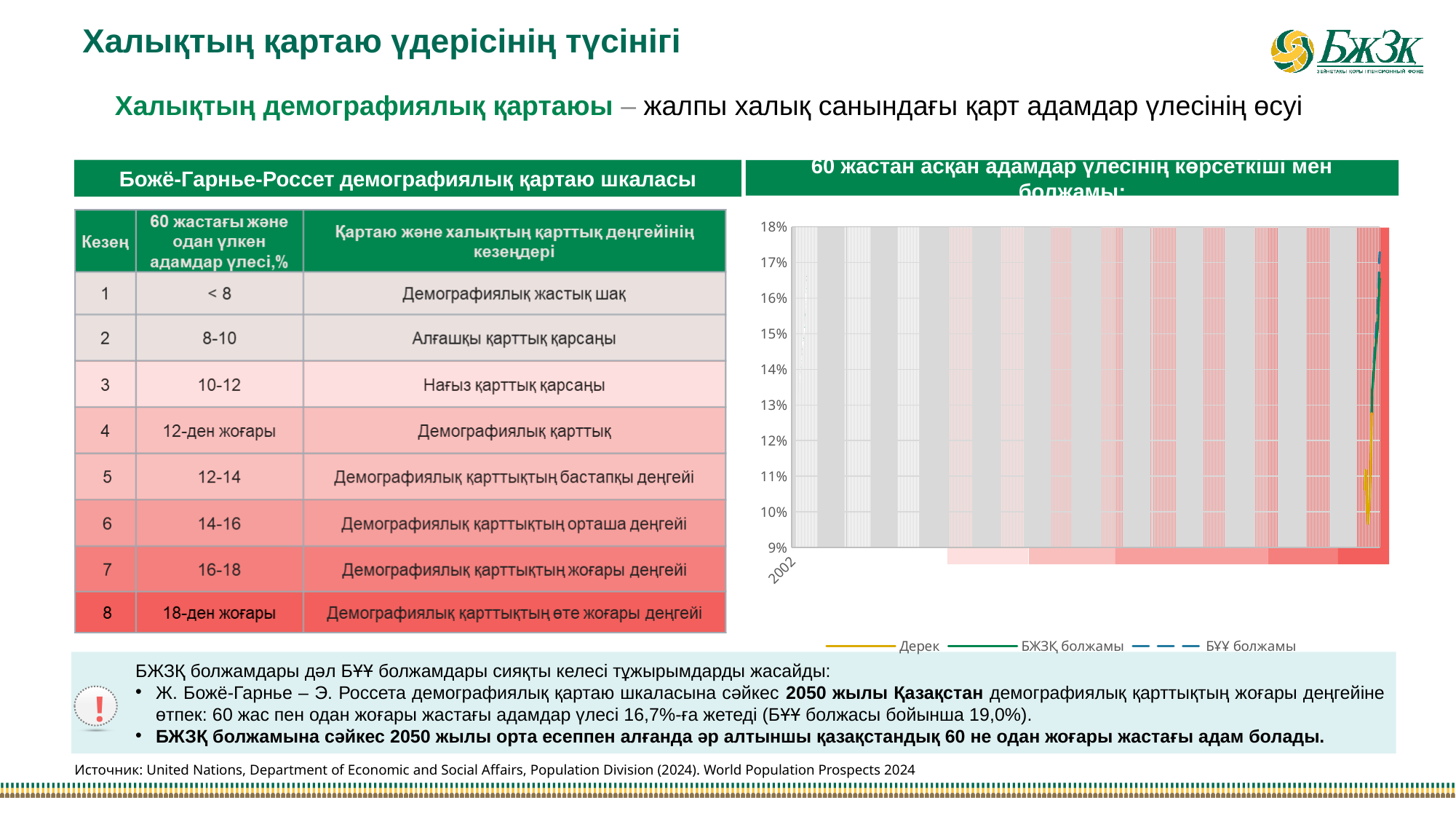
In the chart on the right, do the plotted values rise or fall along the x axis? rise What kind of chart is shown under the title '60 жастан асқан адамдар үлесінің көрсеткіші мен болжамы'? line chart How many series does the legend of the chart on the right list? 3 In the chart on the right, what colour is the line for the series 'Дерек'? yellow In the chart on the right, which legend entry is drawn with a dashed blue line? БҰҰ болжамы